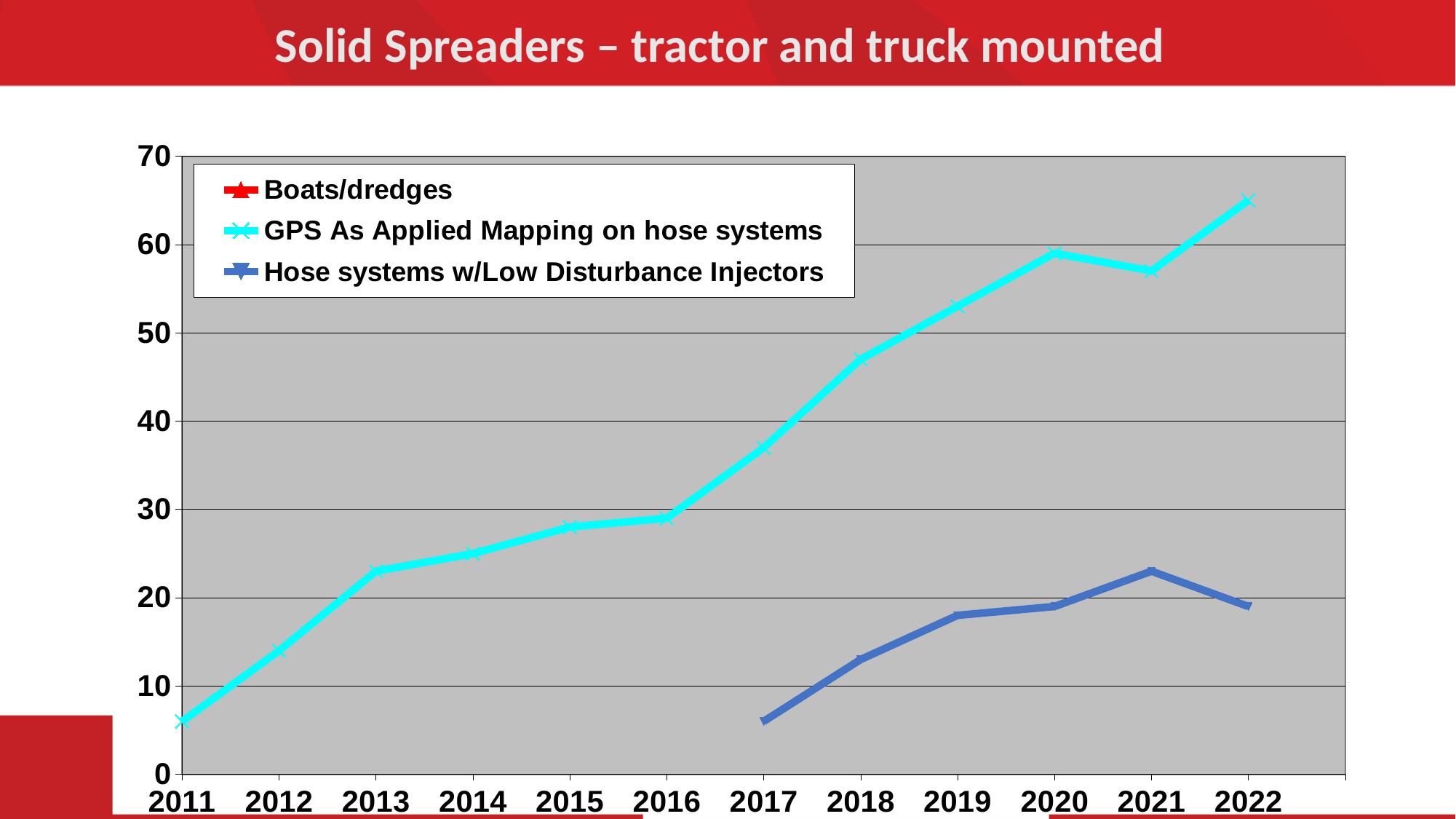
Is the value for GPS As Applied Mapping on hose systems in 2022 greater or less than 60? greater What is the title of the slide containing the chart? Solid Spreaders – tractor and truck mounted In 2020, which series has the larger value: GPS As Applied Mapping on hose systems or Hose systems w/Low Disturbance Injectors? GPS As Applied Mapping on hose systems How many years are shown on the x axis? 12 Is the value for Hose systems w/Low Disturbance Injectors in 2021 greater or less than 20? greater Does the GPS As Applied Mapping on hose systems line generally rise or fall from 2011 to 2022? rise Is the value for GPS As Applied Mapping on hose systems in 2011 greater or less than 10? less Which year has the lowest value for GPS As Applied Mapping on hose systems? 2011 How many series does the legend list? 3 What kind of chart is shown on the slide? line chart Which year has the highest value for Hose systems w/Low Disturbance Injectors? 2021 Which year has the highest value for GPS As Applied Mapping on hose systems? 2022